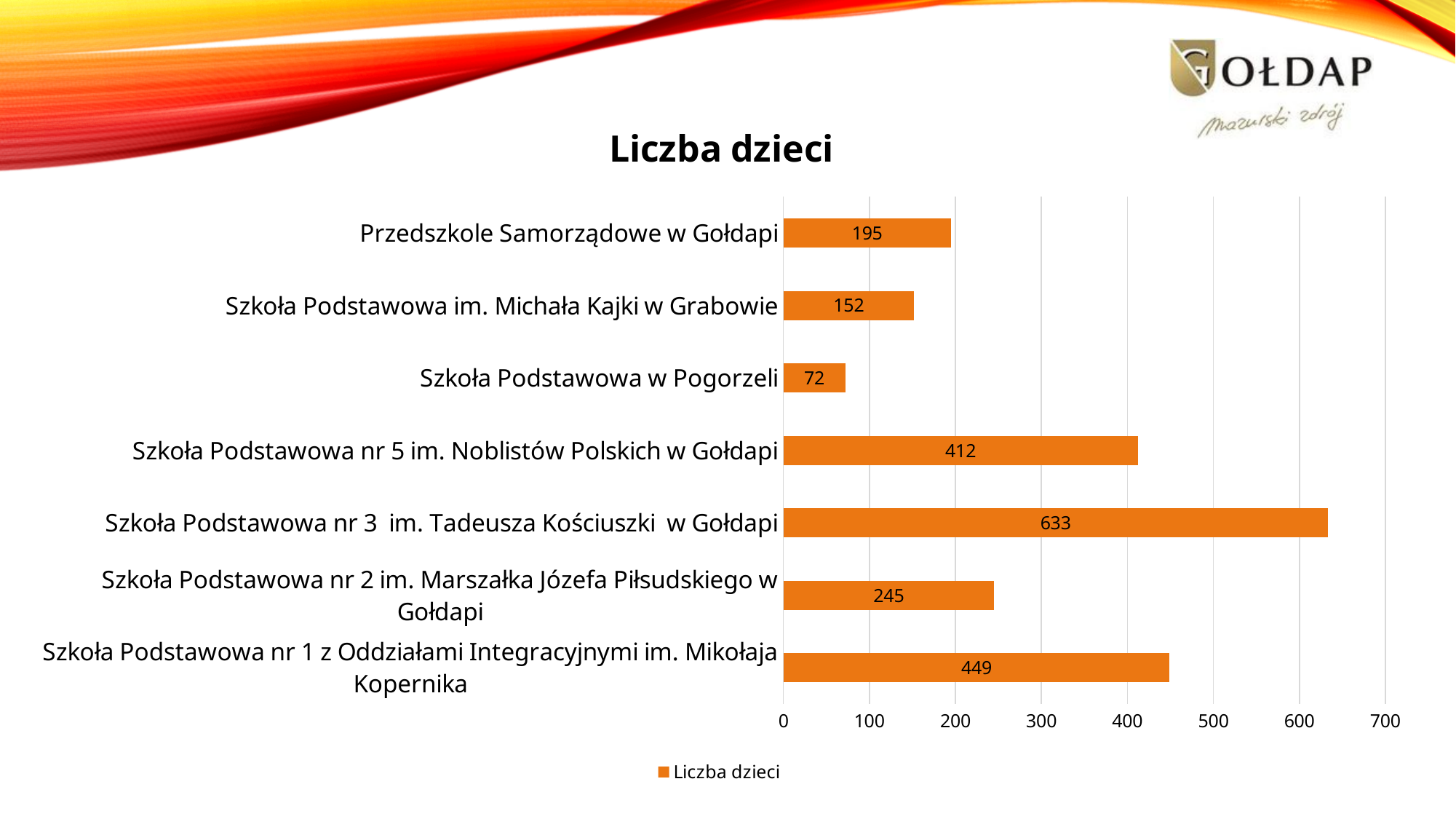
Is the value for Szkoła Podstawowa nr 3 im. Tadeusza Kościuszki w Gołdapi greater or less than 600? greater What is the difference between the values for Szkoła Podstawowa nr 1 z Oddziałami Integracyjnymi im. Mikołaja Kopernika and Szkoła Podstawowa nr 2 im. Marszałka Józefa Piłsudskiego w Gołdapi? 204 How many categories are shown in the chart? 7 How many series does the legend list? 1 What is the value for Przedszkole Samorządowe w Gołdapi? 195 What is the value for Szkoła Podstawowa nr 5 im. Noblistów Polskich w Gołdapi? 412 What is the title of the chart? Liczba dzieci Which is larger: the value for Szkoła Podstawowa im. Michała Kajki w Grabowie or the value for Przedszkole Samorządowe w Gołdapi? Przedszkole Samorządowe w Gołdapi Which category has the highest value? Szkoła Podstawowa nr 3 im. Tadeusza Kościuszki w Gołdapi What kind of chart is shown on the slide? bar chart What is the value for Szkoła Podstawowa w Pogorzeli? 72 Which category has the lowest value? Szkoła Podstawowa w Pogorzeli